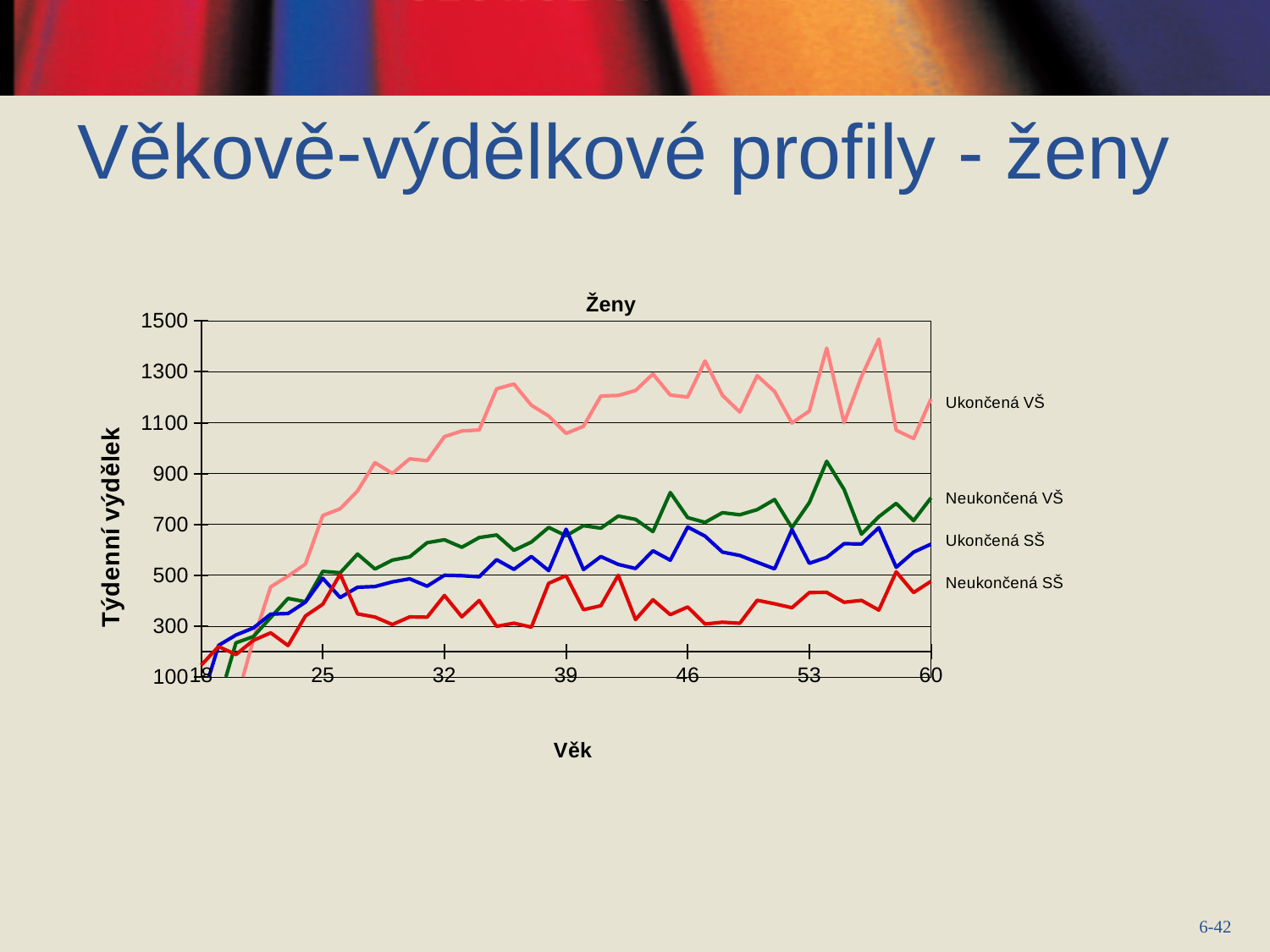
Does the Ukončená VŠ series generally rise or fall between age 18 and age 39? rise Which series has the highest weekly earnings across most of the age range? Ukončená VŠ Which series has the lowest weekly earnings across most of the age range? Neukončená SŠ What is the title of the chart? Ženy Is the value for Neukončená SŠ at age 46 greater or less than 500? less What kind of chart is shown on the slide? line chart Is the value for Ukončená VŠ at age 46 greater or less than 1100? greater How many series are plotted on the chart? 4 Is the value for Ukončená SŠ at age 32 greater or less than 700? less At age 53, which is larger: the value for Ukončená VŠ or the value for Neukončená VŠ? Ukončená VŠ At age 39, which is larger: the value for Neukončená VŠ or the value for Neukončená SŠ? Neukončená VŠ What is the label of the y axis? Týdenní výdělek